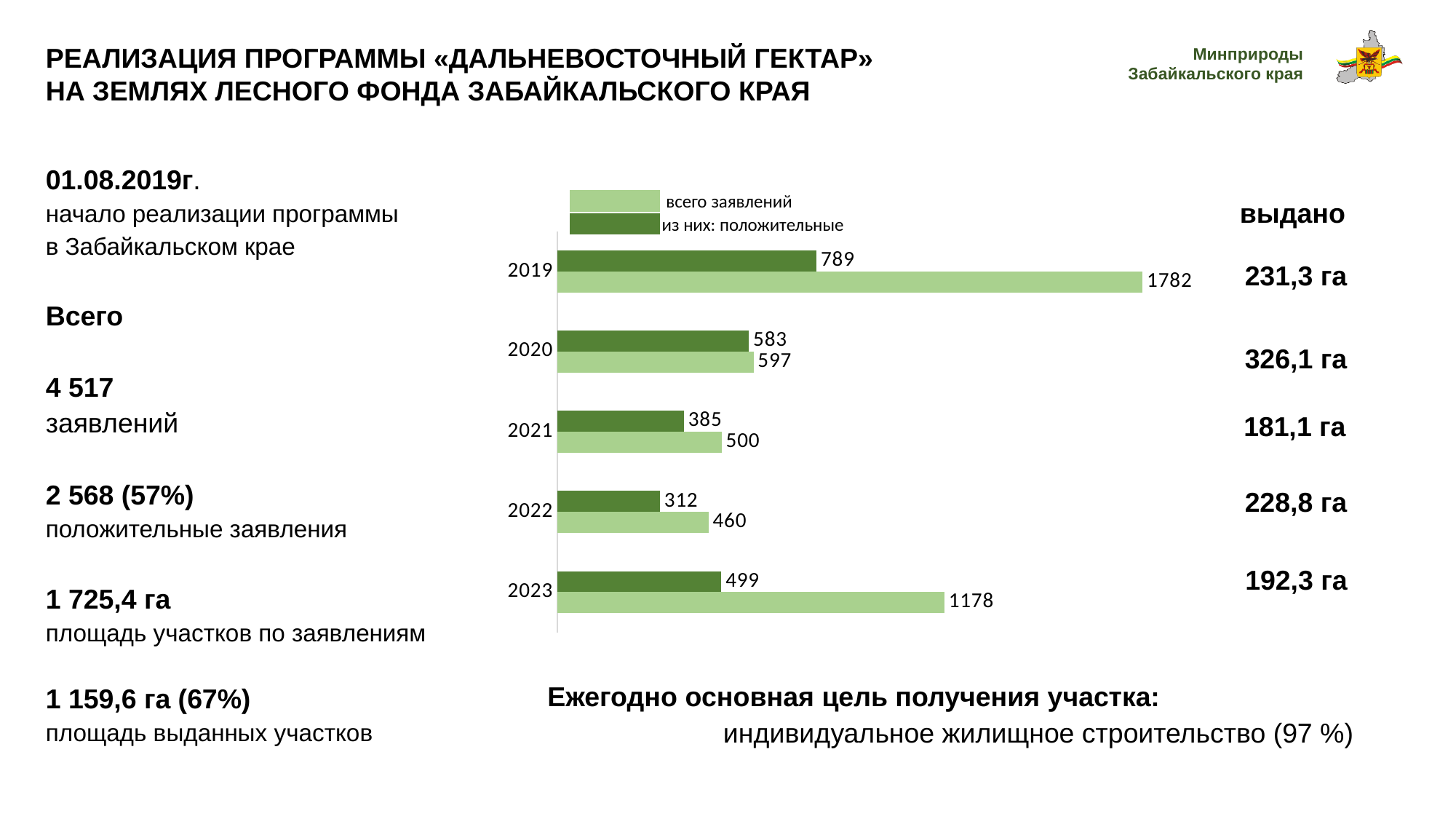
Which year has the highest value for 'всего заявлений'? 2019 What is the difference between 'всего заявлений' for 2023 and 2021? 678 How many series does the legend list? 2 What kind of chart is shown on the slide? Bar chart Which is larger: 'из них: положительные' for 2020 or for 2023? 2020 Which colour represents 'из них: положительные' in the chart? Dark green What is the value of 'всего заявлений' for 2019? 1782 What is the value of 'всего заявлений' for 2022? 460 What is the value of 'из них: положительные' for 2023? 499 Which year has the lowest value for 'из них: положительные'? 2022 How many years are shown on the chart? 5 What is the difference between 'всего заявлений' and 'из них: положительные' for 2020? 14